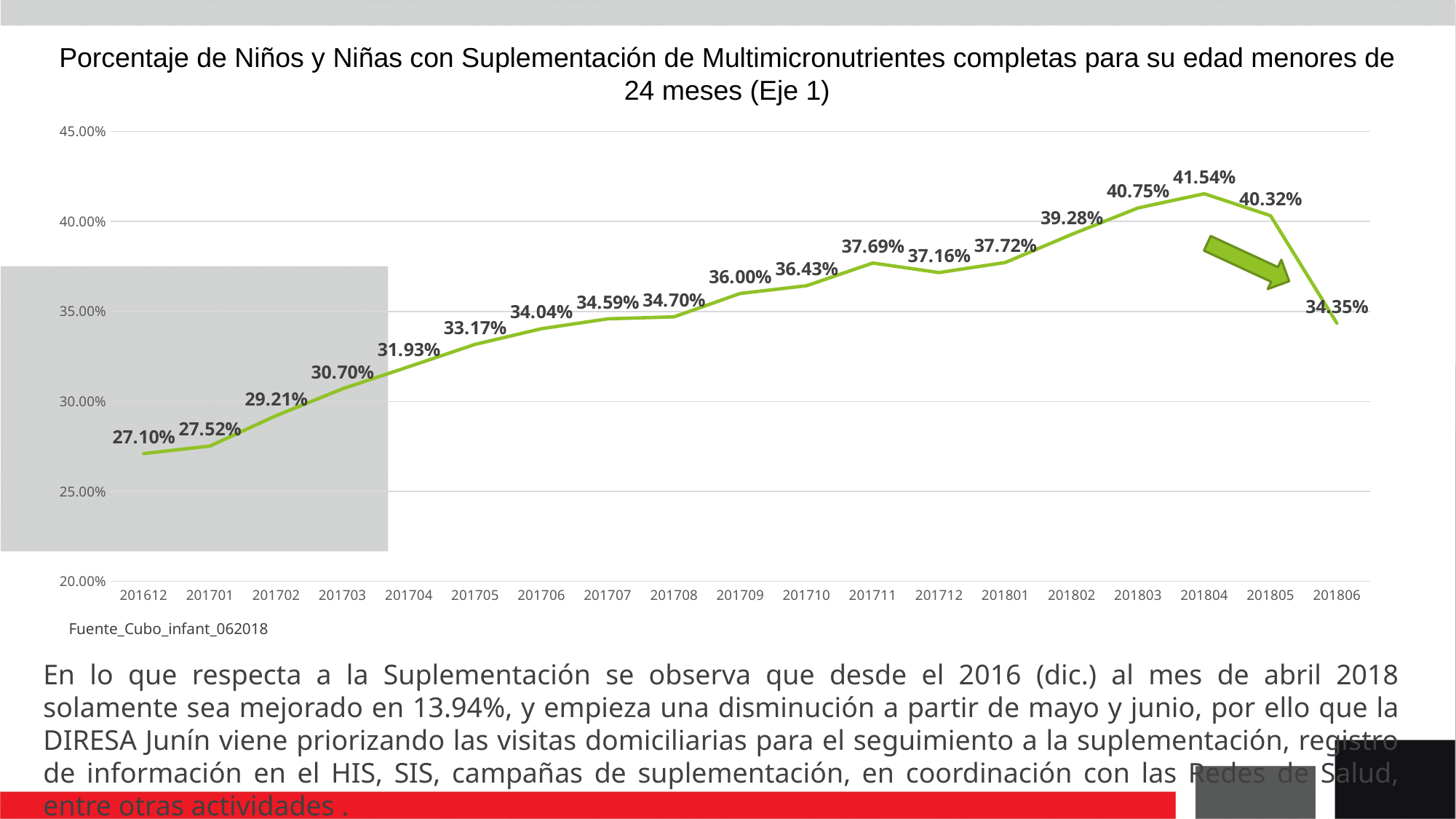
Which is larger, the value for 201711 or the value for 201712? 201711 How many data points are plotted on the line? 19 What is the difference between the values for 201804 and 201612? 14.44% What is the value for 201709? 36.00% What type of chart is shown on the slide? Line chart What is the source noted below the chart? Fuente_Cubo_infant_062018 What is the value for 201612? 27.10% What is the value for 201804? 41.54% Which period has the highest value? 201804 What is the value for 201806? 34.35% Which period has the lowest value? 201612 What is the difference between the values for 201805 and 201806? 5.97%